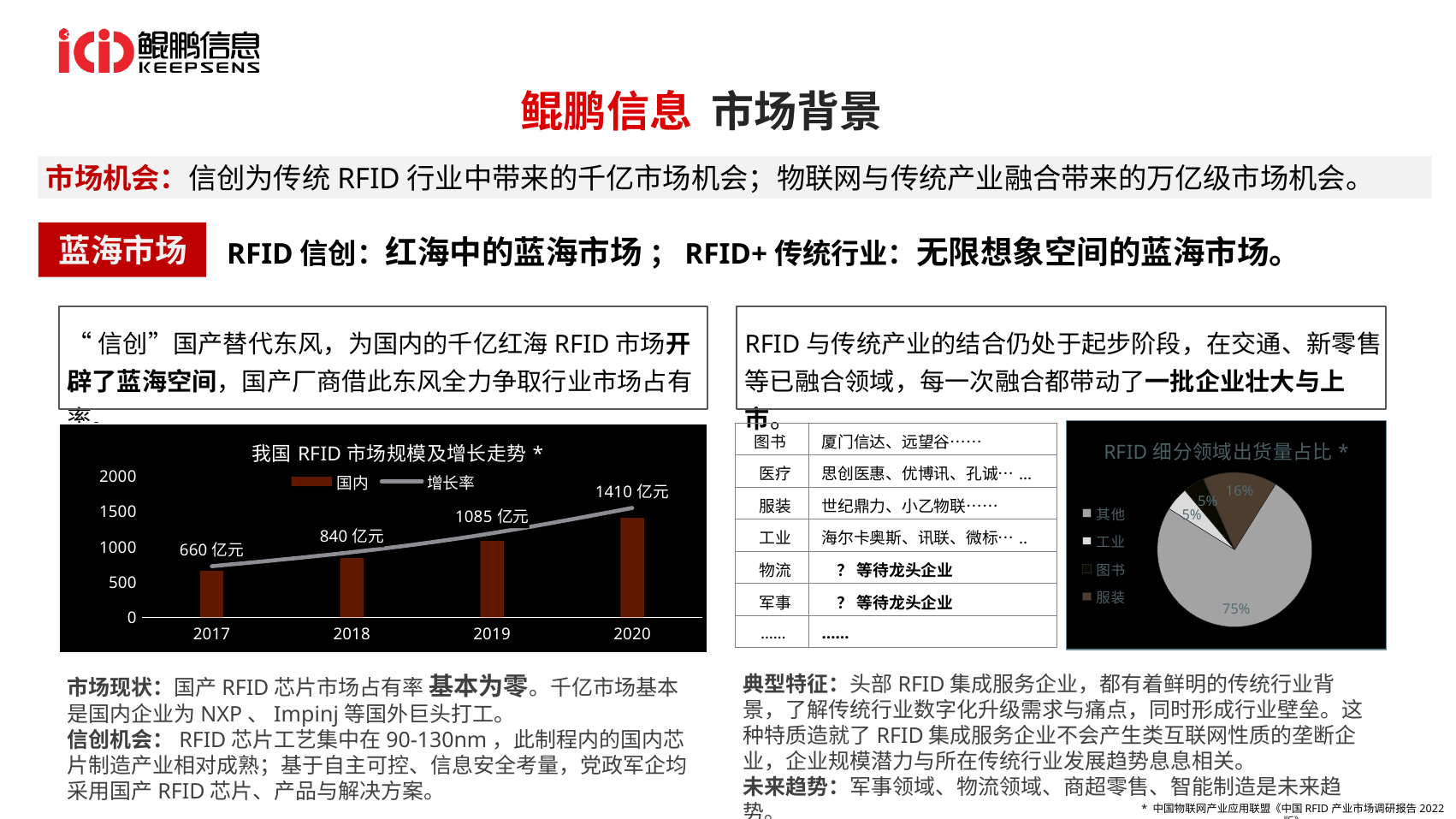
In the chart titled RFID 细分领域出货量占比, how many categories does the legend list? 4 In the chart titled 我国 RFID 市场规模及增长走势, which year has the lowest value? 2017 In the chart titled RFID 细分领域出货量占比, what kind of chart is it? pie chart In the chart titled 我国 RFID 市场规模及增长走势, what is the difference between the 2020 value and the 2017 value? 750 亿元 In the chart titled 我国 RFID 市场规模及增长走势, what is the value for 2017? 660 亿元 In the chart titled 我国 RFID 市场规模及增长走势, how many series does the legend list? 2 In the chart titled RFID 细分领域出货量占比, what share does the largest slice have? 75% In the chart titled 我国 RFID 市场规模及增长走势, which is larger, the value for 2018 or the value for 2019? 2019 In the chart titled 我国 RFID 市场规模及增长走势, which year has the highest value? 2020 In the chart titled 我国 RFID 市场规模及增长走势, how many years are shown on the x axis? 4 In the chart titled 我国 RFID 市场规模及增长走势, what is the value for 2020? 1410 亿元 In the chart titled 我国 RFID 市场规模及增长走势, do the bar values rise or fall from 2017 to 2020? rise